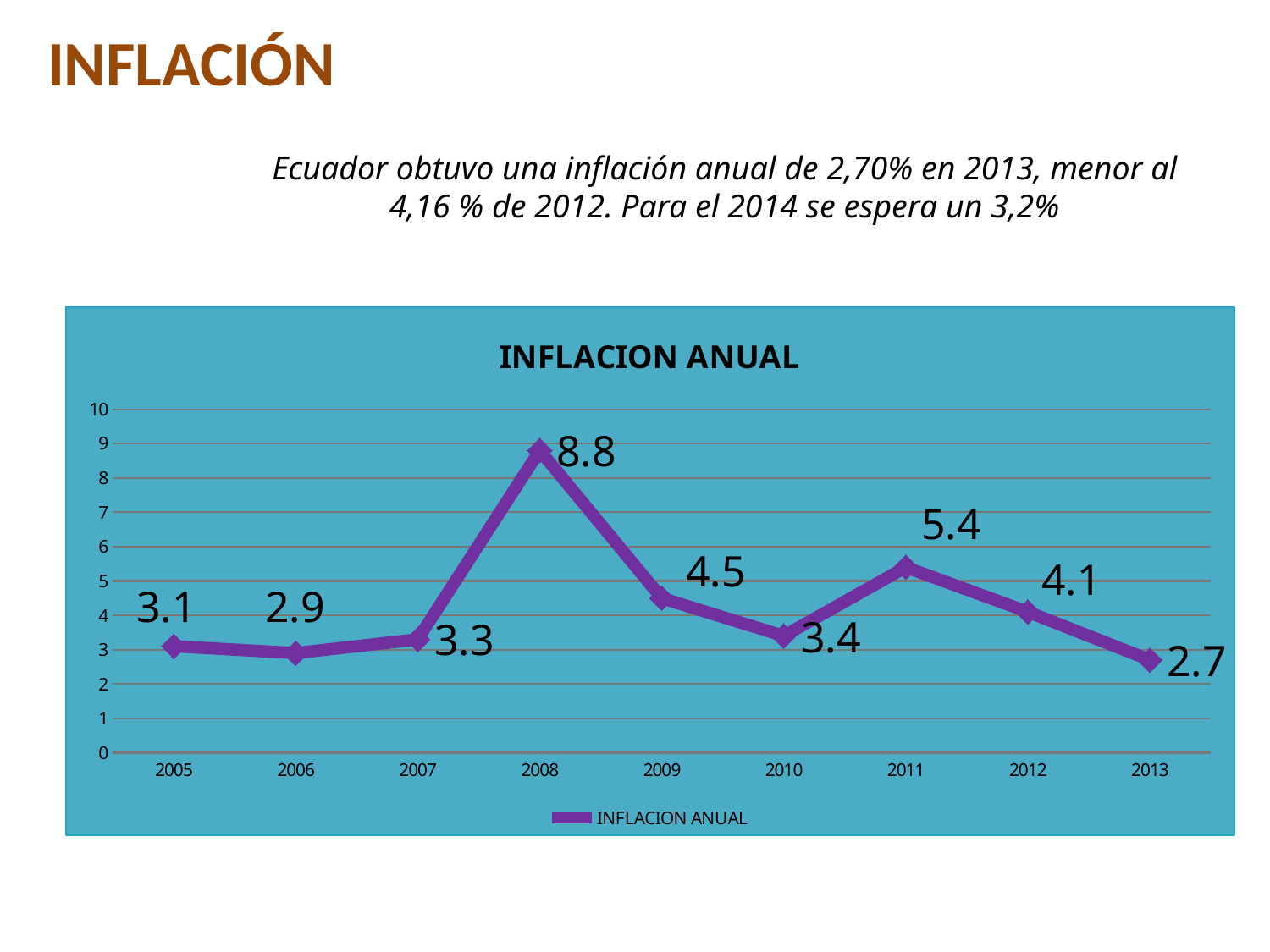
What is the value for 2008 in the INFLACION ANUAL chart? 8.8 Which year has the lowest value in the INFLACION ANUAL chart? 2013 What is the value for 2013 in the INFLACION ANUAL chart? 2.7 How many series does the legend of the INFLACION ANUAL chart list? 1 Which is larger in the INFLACION ANUAL chart, the value for 2011 or the value for 2012? 2011 What is the value for 2011 in the INFLACION ANUAL chart? 5.4 How many years are plotted in the INFLACION ANUAL chart? 9 What is the difference between the values for 2012 and 2013 in the INFLACION ANUAL chart? 1.4 Do the values in the INFLACION ANUAL chart rise or fall from 2011 to 2013? Fall Which year has the highest value in the INFLACION ANUAL chart? 2008 What kind of chart is the INFLACION ANUAL chart? Line chart What is the difference between the values for 2008 and 2009 in the INFLACION ANUAL chart? 4.3